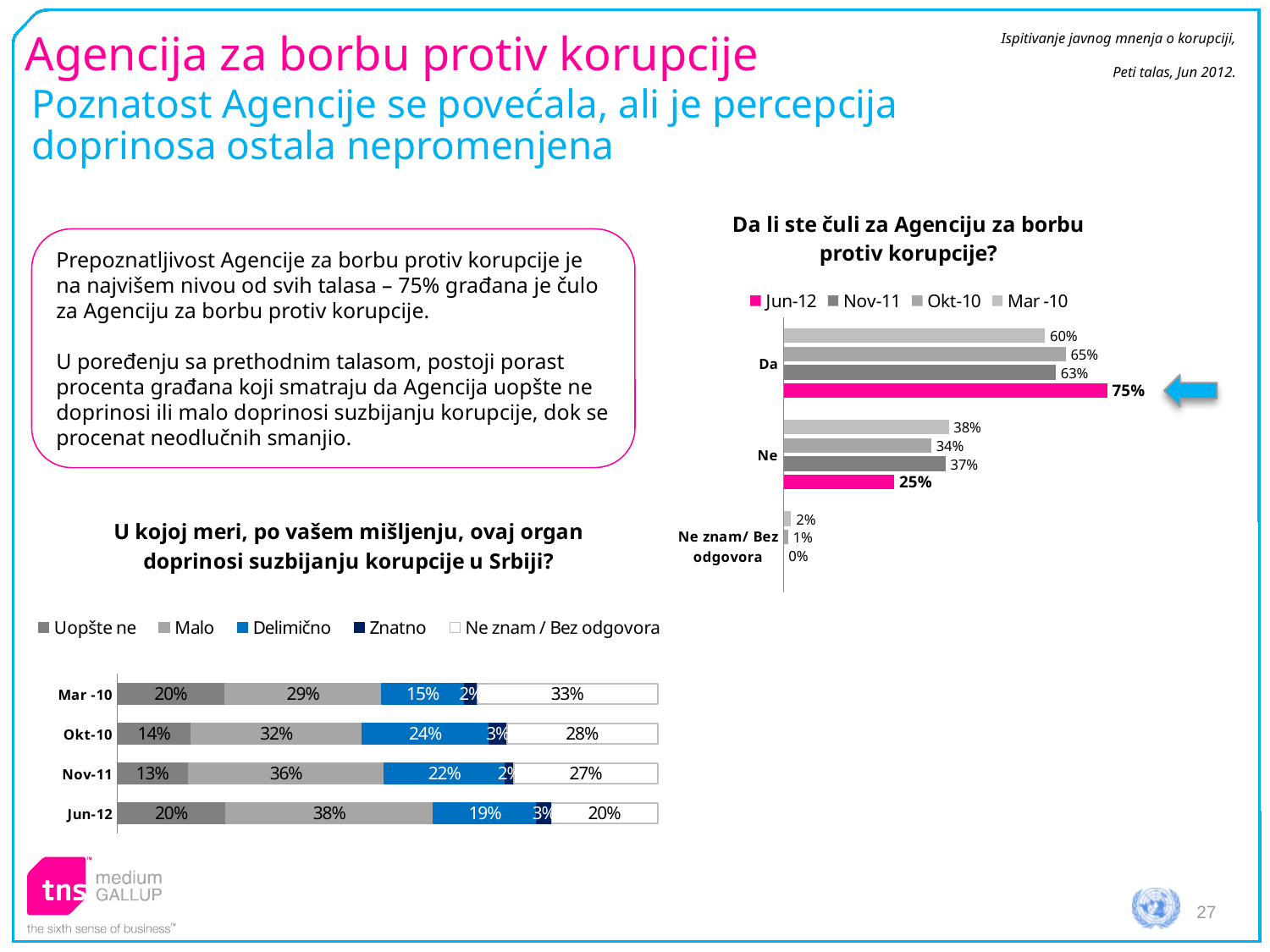
In the chart 'U kojoj meri, po vašem mišljenju, ovaj organ doprinosi suzbijanju korupcije u Srbiji?', what is the 'Ne znam / Bez odgovora' value for Mar -10? 33% In the chart 'Da li ste čuli za Agenciju za borbu protiv korupcije?', how many series does the legend list? 4 In the chart 'U kojoj meri, po vašem mišljenju, ovaj organ doprinosi suzbijanju korupcije u Srbiji?', how many series does the legend list? 5 In the chart 'Da li ste čuli za Agenciju za borbu protiv korupcije?', what is the difference between the Jun-12 values for 'Da' and 'Ne'? 50% In the chart 'U kojoj meri, po vašem mišljenju, ovaj organ doprinosi suzbijanju korupcije u Srbiji?', which wave has the highest 'Delimično' value? Okt-10 In the chart 'Da li ste čuli za Agenciju za borbu protiv korupcije?', how many answer categories are shown on the axis? 3 In the chart 'Da li ste čuli za Agenciju za borbu protiv korupcije?', which wave has the highest value for 'Da'? Jun-12 In the chart 'Da li ste čuli za Agenciju za borbu protiv korupcije?', which wave has the lowest value for 'Ne'? Jun-12 What type of chart is 'U kojoj meri, po vašem mišljenju, ovaj organ doprinosi suzbijanju korupcije u Srbiji?'? Stacked bar chart In the chart 'Da li ste čuli za Agenciju za borbu protiv korupcije?', what is the Jun-12 value for 'Da'? 75% In the chart 'Da li ste čuli za Agenciju za borbu protiv korupcije?', what is the Jun-12 value for 'Ne'? 25% In the chart 'U kojoj meri, po vašem mišljenju, ovaj organ doprinosi suzbijanju korupcije u Srbiji?', what is the 'Malo' value for Jun-12? 38%